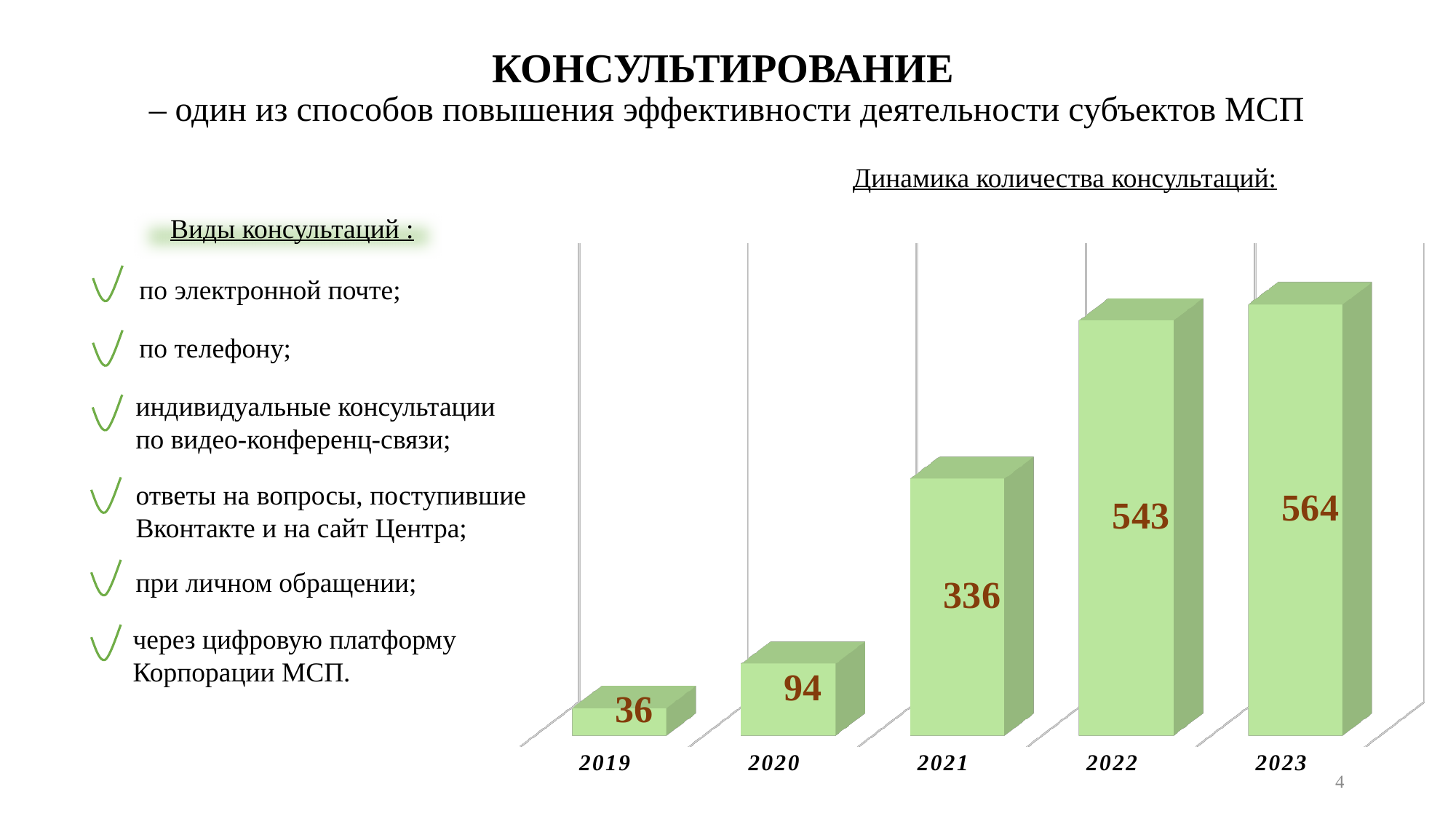
What is the difference between the number of consultations in 2020 and in 2019? 58 What is the difference between the number of consultations in 2022 and in 2021? 207 What is the number of consultations shown for 2021? 336 Which year has the highest number of consultations? 2023 How many years are shown on the chart? 5 What is the number of consultations shown for 2019? 36 Which year has more consultations, 2020 or 2021? 2021 What is the title of the chart? Динамика количества консультаций Which year has the lowest number of consultations? 2019 What kind of chart is used to show the dynamics of the number of consultations? Bar chart Do the number of consultations rise or fall from 2019 to 2023? Rise What is the number of consultations shown for 2023? 564